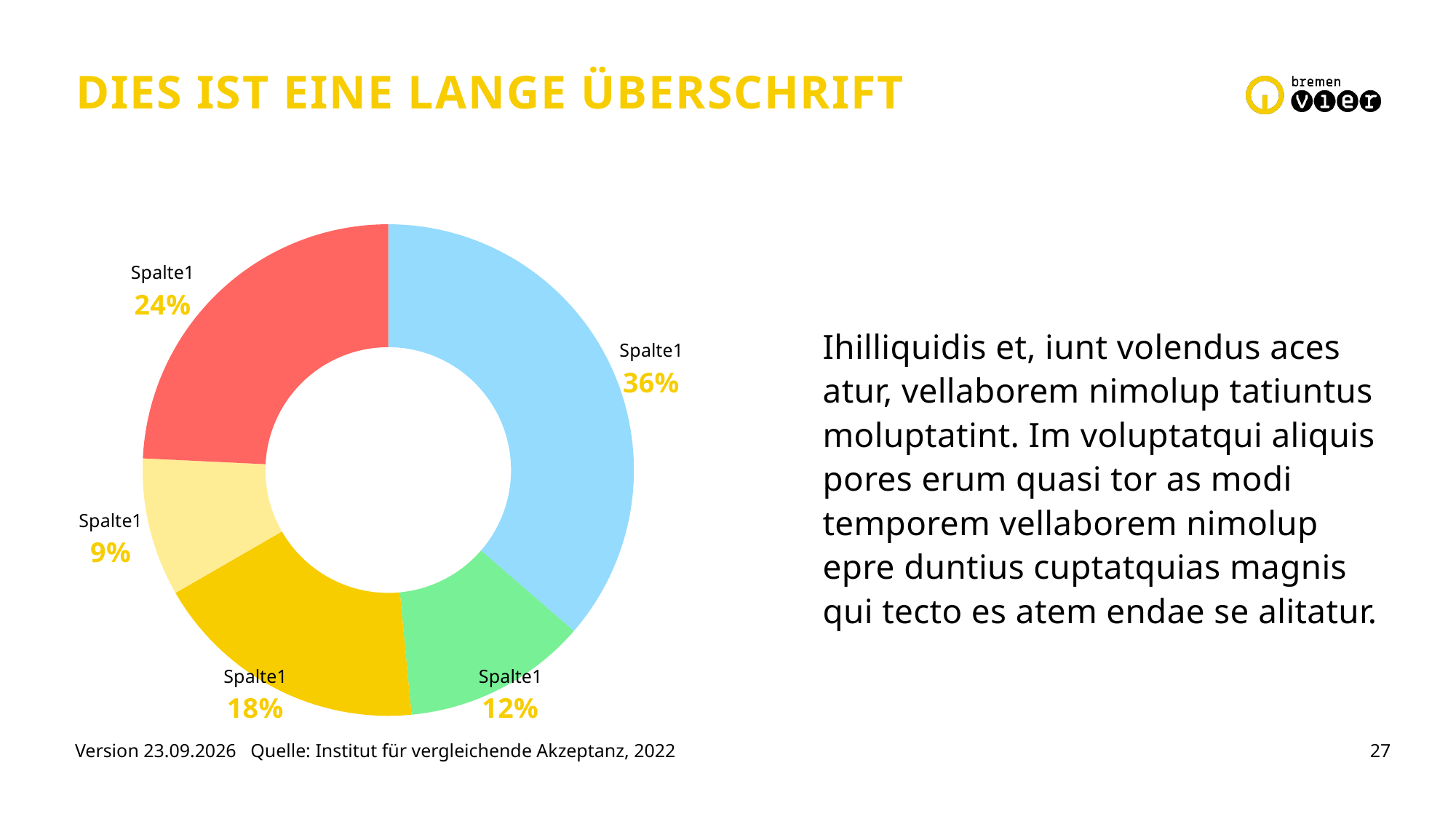
What kind of chart is shown on the slide? pie chart (donut) What percentage is shown for the dark yellow slice of the pie chart? 18% Which slice of the pie chart has the smallest share? the pale yellow slice (9%) What is the difference between the light blue slice and the red slice in the pie chart? 12% What percentage is shown for the pale yellow slice of the pie chart? 9% Which slice of the pie chart has the largest share? the light blue slice (36%) What percentage is shown for the green slice of the pie chart? 12% What percentage is shown for the red slice of the pie chart? 24% Which is larger in the pie chart, the green slice or the dark yellow slice? the dark yellow slice How many slices does the pie chart have? 5 What label is shown for every slice of the pie chart? Spalte1 What percentage is shown for the light blue slice of the pie chart? 36%